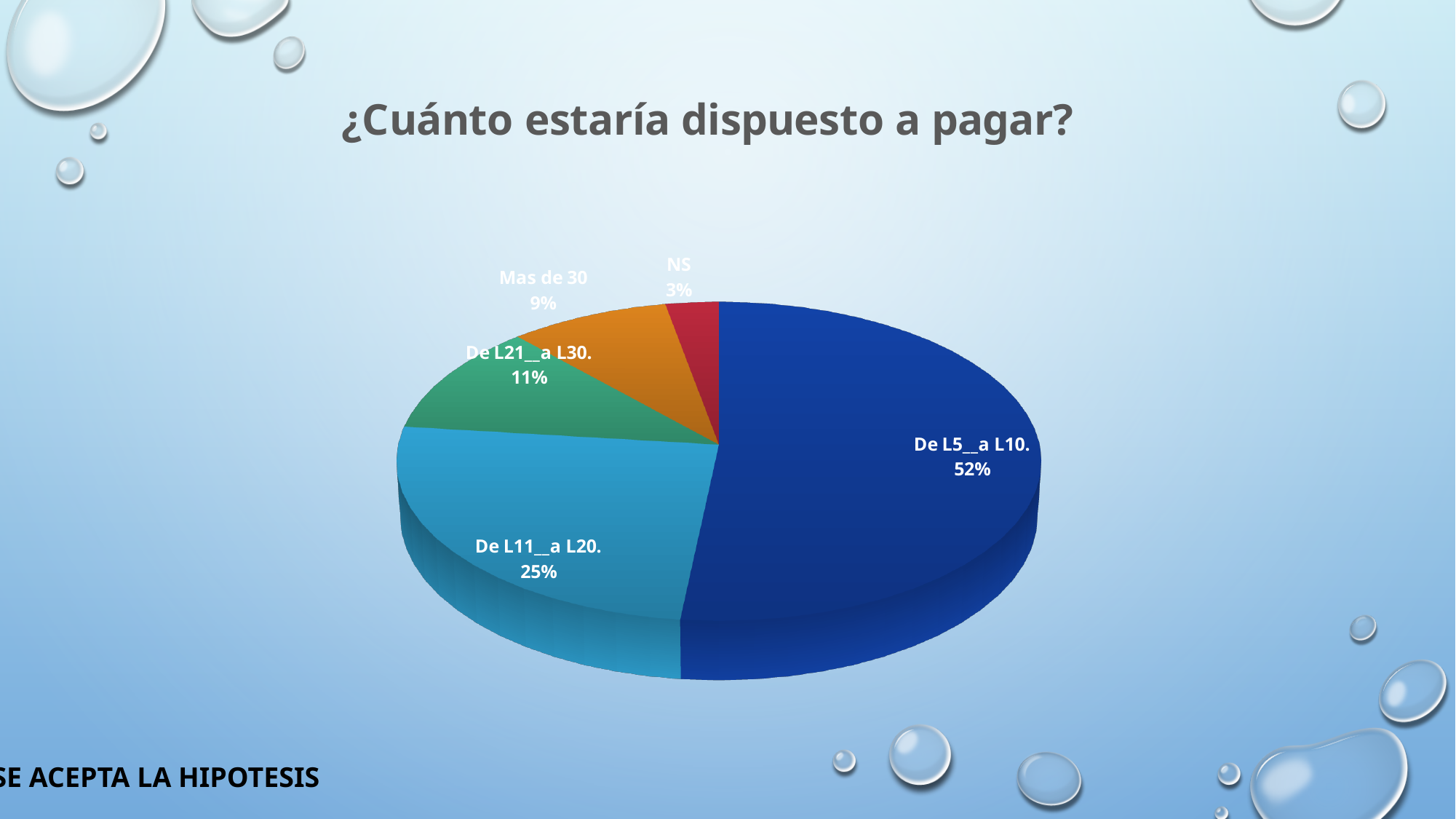
What is the difference in percentage points between 'De L5__a L10.' and 'De L11__a L20.'? 27 What share of the pie does the 'De L5__a L10.' slice represent? 52% What kind of chart is shown on the slide? Pie chart What is the value shown for 'De L11__a L20.'? 25% Which category has the smallest slice of the pie? NS What is the title of the chart? ¿Cuánto estaría dispuesto a pagar? What is the value shown for 'Mas de 30'? 9% Which category has the largest slice of the pie? De L5__a L10. How many categories are shown in the pie chart? 5 Which is larger, 'De L21__a L30.' or 'Mas de 30'? De L21__a L30. What is the value shown for 'NS'? 3% What is the value shown for 'De L21__a L30.'? 11%